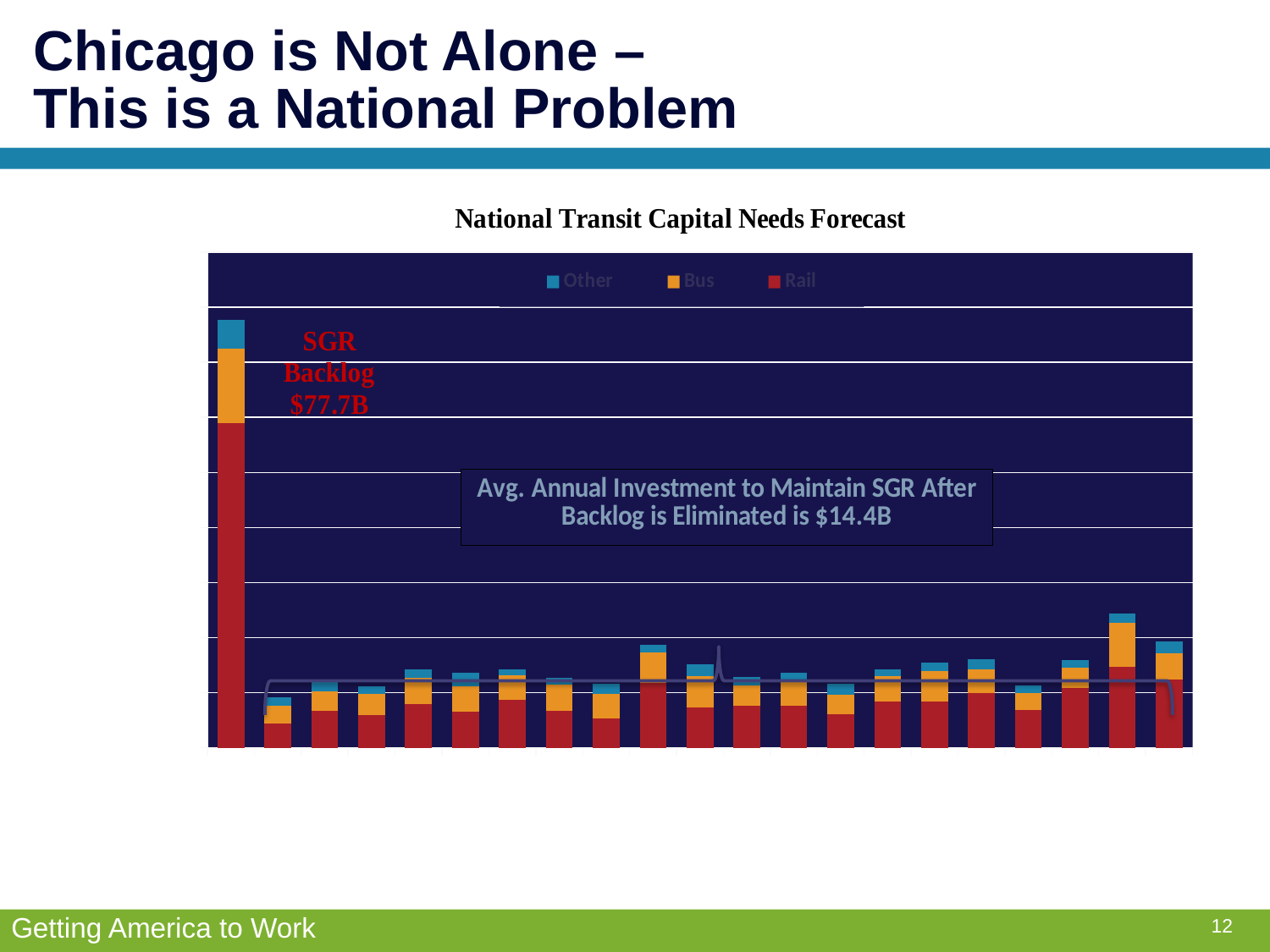
Which series makes up the largest portion of the SGR Backlog bar? Rail What are the series names listed in the chart legend? Other, Bus, Rail What is the value of the SGR Backlog shown on the chart? $77.7B What type of chart is shown on the slide? Stacked bar chart Which bar in the chart is the tallest? The SGR Backlog bar What is the title of the chart? National Transit Capital Needs Forecast Which series is plotted at the bottom of each stacked bar? Rail How many series does the chart legend list? 3 Is the SGR Backlog bar larger or smaller than the other bars in the chart? Larger According to the chart annotation, what is the average annual investment needed to maintain SGR after the backlog is eliminated? $14.4B